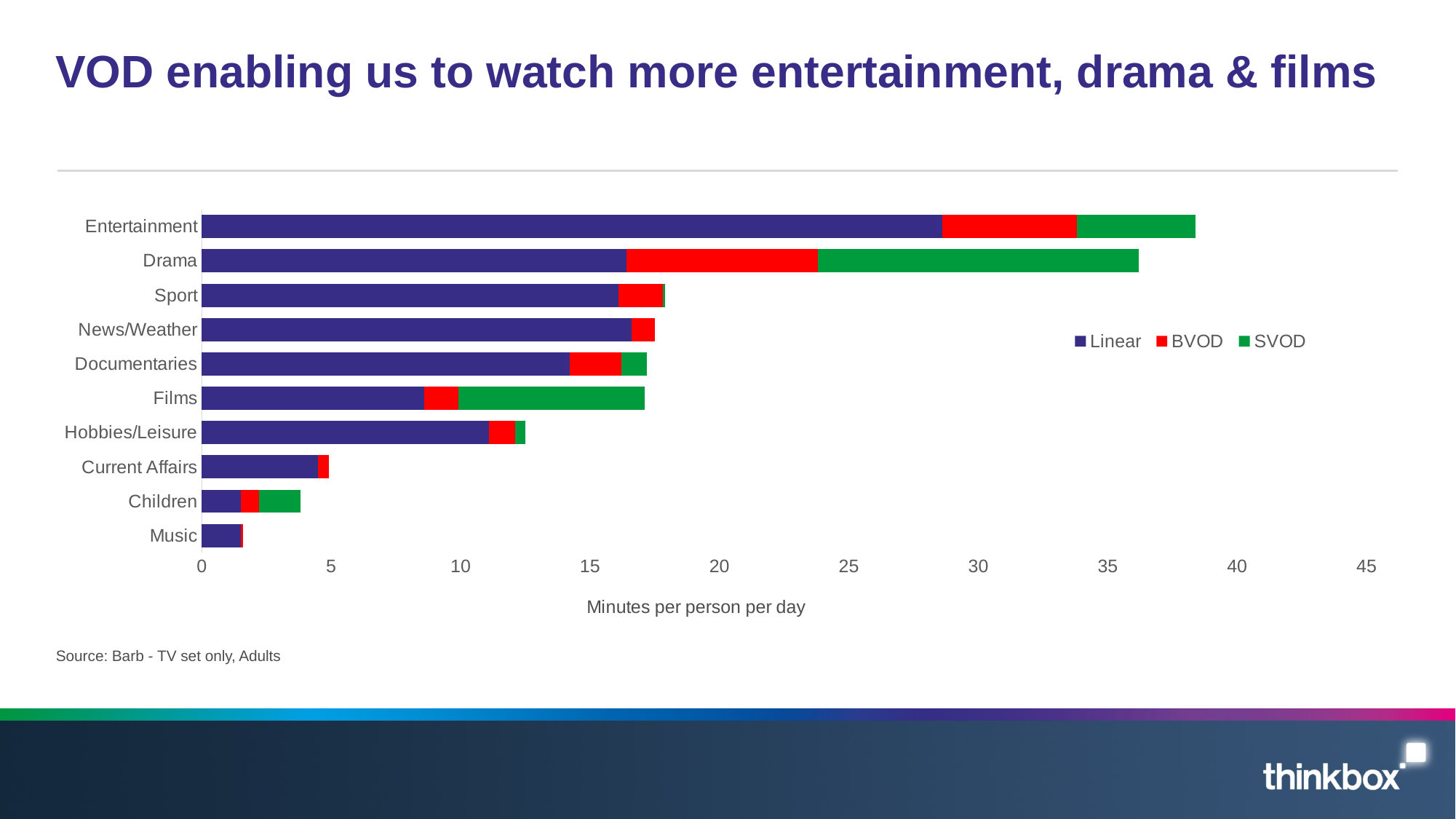
What kind of chart is shown on the slide? Stacked bar chart Is the total value for Sport greater or less than 20? less How many series does the legend list? 3 Which has the larger total bar, Sport or Hobbies/Leisure? Sport Is the total value for Children greater or less than 5? less How many categories (genres) are plotted on the chart? 10 Which genre has the shortest total bar? Music Which genre has the longest total bar? Entertainment What is the label on the x axis of the chart? Minutes per person per day Is the total value for Entertainment greater or less than 35? greater Which has the larger total bar, Drama or Sport? Drama